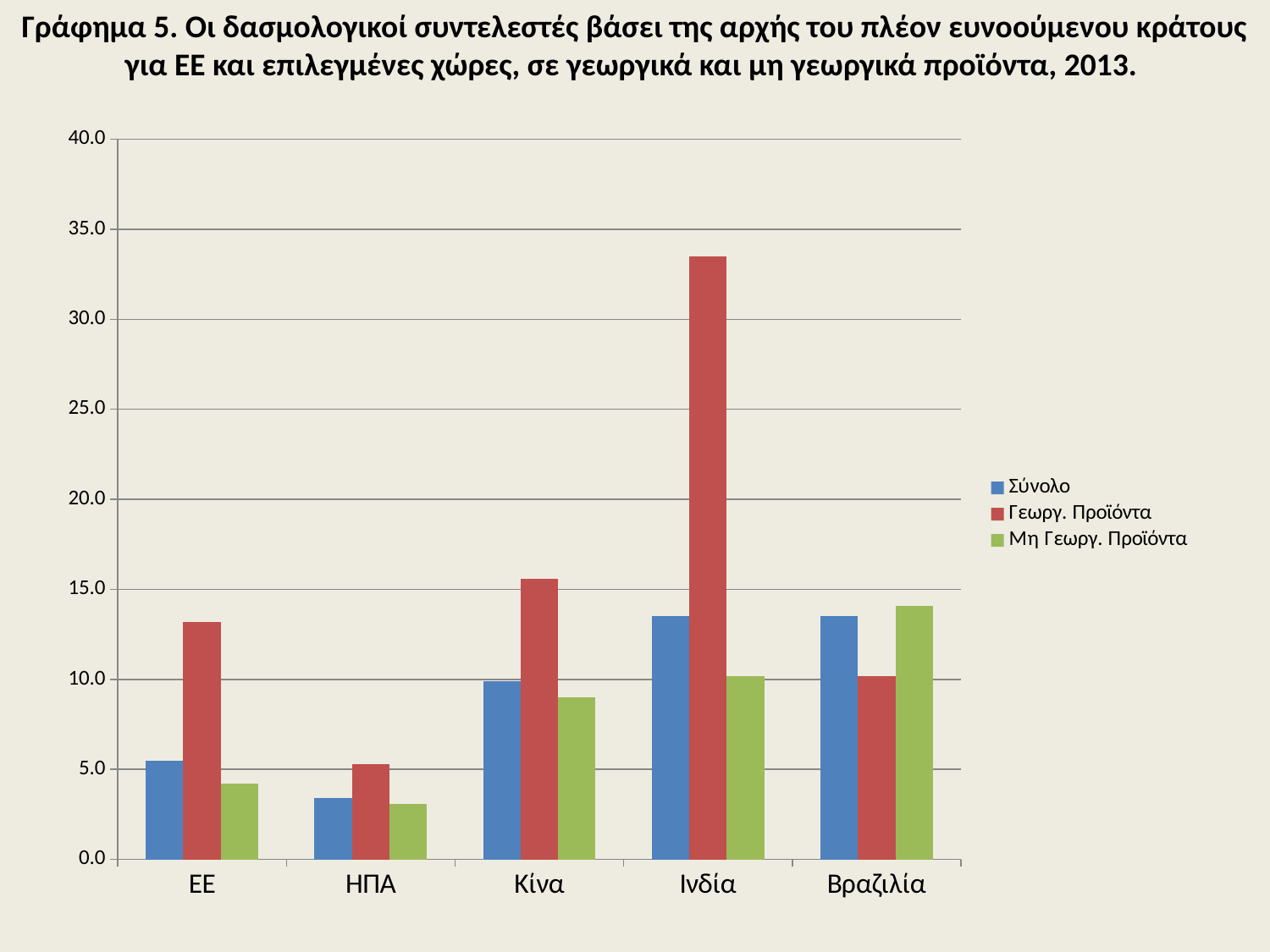
How many countries/regions are shown on the x axis of the chart? 5 Is the Γεωργ. Προϊόντα value for Ινδία greater or less than 30.0? greater Which country has the lowest value for Σύνολο? ΗΠΑ What kind of chart is shown on the slide? bar chart Which country has the highest value for Μη Γεωργ. Προϊόντα? Βραζιλία For Βραζιλία, which is larger: Γεωργ. Προϊόντα or Μη Γεωργ. Προϊόντα? Μη Γεωργ. Προϊόντα For ΕΕ, which is larger: Σύνολο or Γεωργ. Προϊόντα? Γεωργ. Προϊόντα Which colour represents the Σύνολο series in the chart? blue Is the Γεωργ. Προϊόντα value for ΕΕ greater or less than 10.0? greater How many series does the legend list? 3 Which country has the highest value for Γεωργ. Προϊόντα? Ινδία Is the Σύνολο value for ΗΠΑ greater or less than 5.0? less